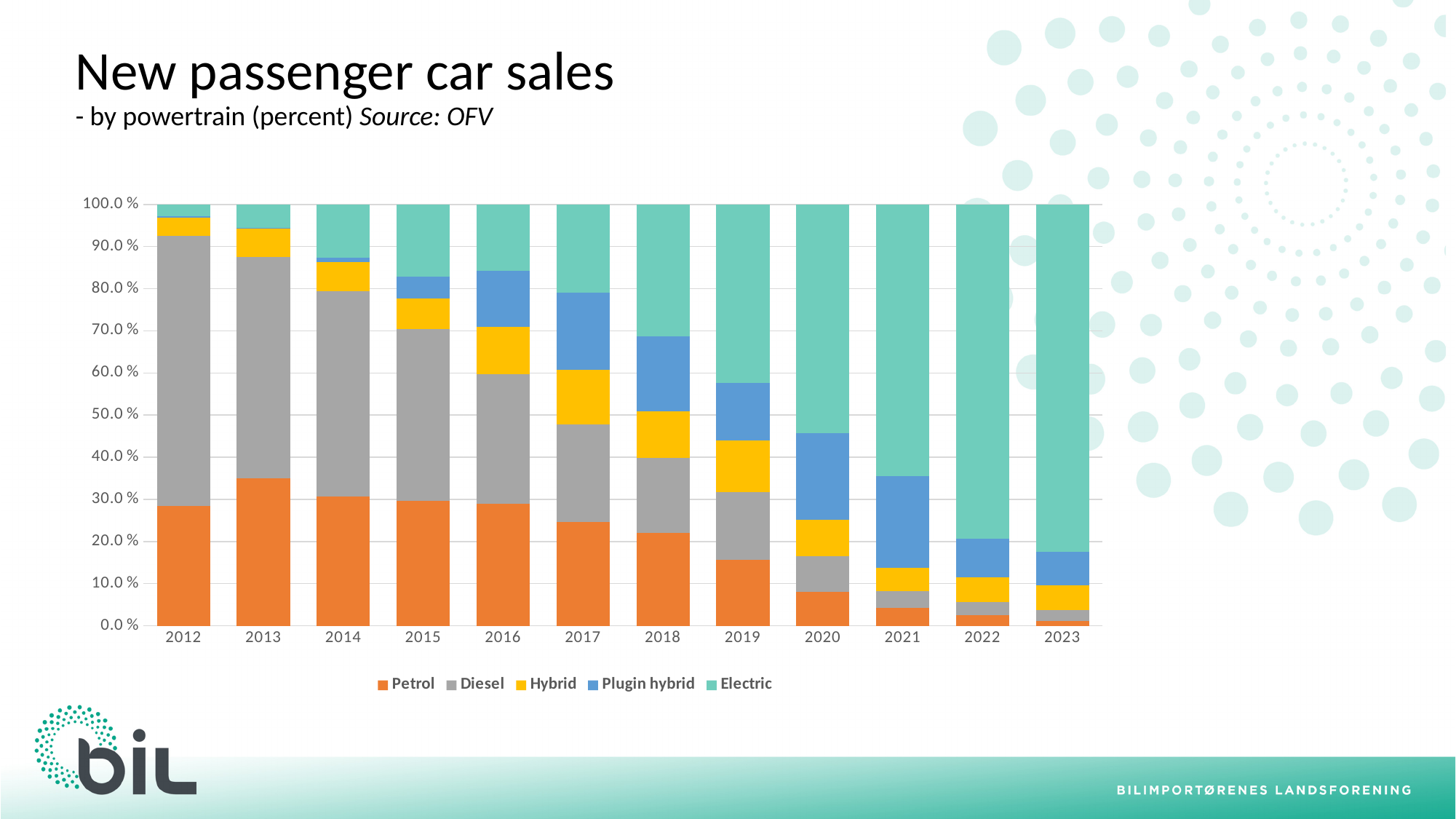
What is the title of the chart on the slide? New passenger car sales Does the Electric share rise or fall from 2012 to 2023? rise Is the Electric share in 2023 greater or less than 80.0 %? greater In which year is the Diesel share the highest? 2012 What kind of chart is shown on the slide? Stacked bar chart Is the Electric share in 2021 greater or less than 60.0 %? greater Is the Petrol share in 2013 greater or less than 30.0 %? greater How many series does the chart's legend list? 5 How many years are shown on the x axis of the chart? 12 In which year is the Electric share the highest? 2023 Which powertrain series is shown in orange in the chart? Petrol